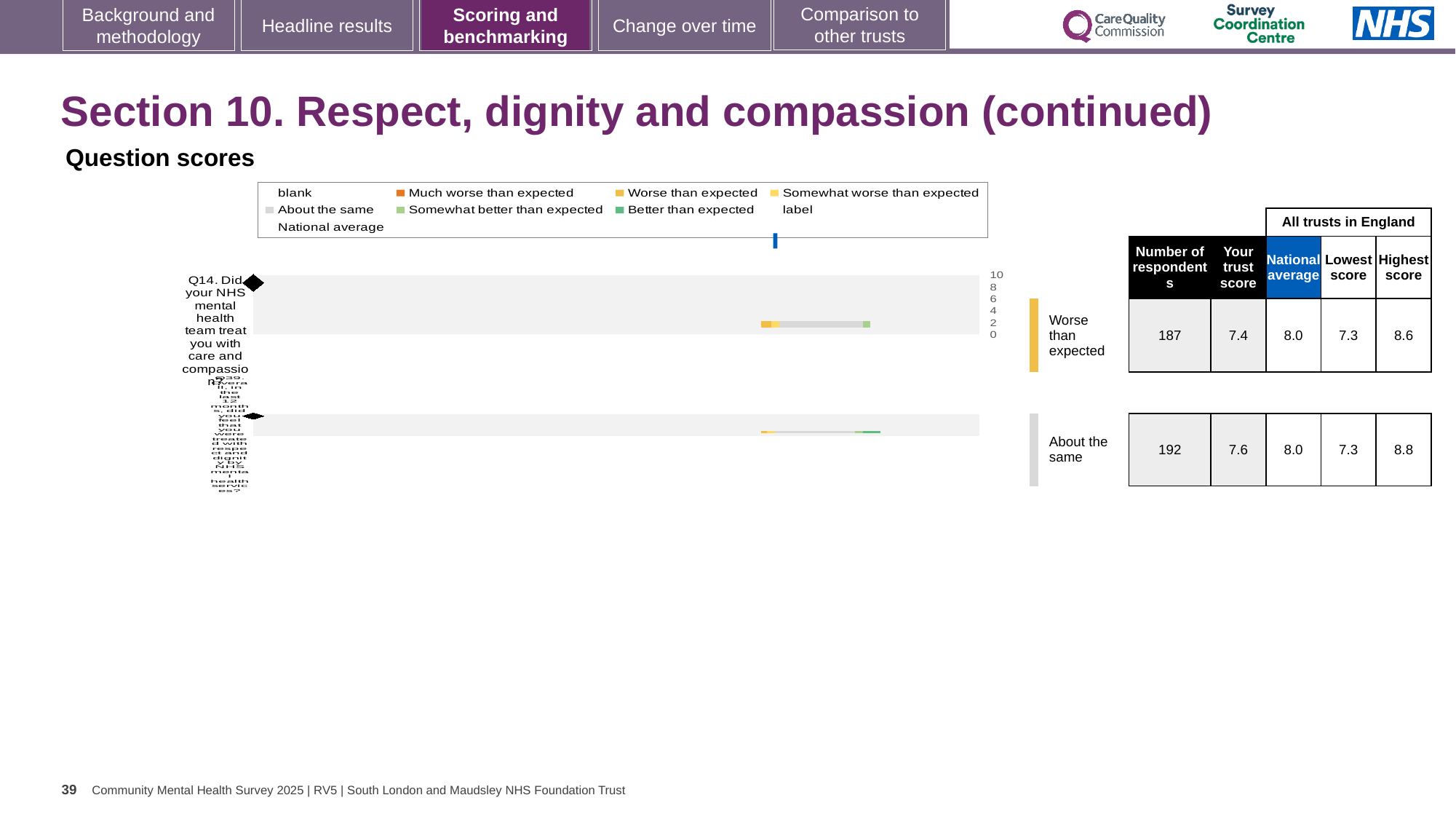
How many questions are plotted in the question scores chart? 2 What is the highest score among all trusts in England for Q39? 8.8 What is the difference between the national average (8.0) and the trust score (7.4) for Q14? 0.6 What type of chart is used to show the question scores on this slide? bar chart How many respondents answered Q14? 187 What is the national average score for Q14? 8.0 What is the difference between the highest score for Q39 (8.8) and the highest score for Q14 (8.6)? 0.2 What is the 'Your trust score' value for the second question (Q39)? 7.6 Which benchmark category is shown for Q14 in the question scores chart? Worse than expected Which question has the higher trust score, Q14 or Q39? Q39 How many respondents answered the second question (Q39)? 192 What is the 'Your trust score' value for Q14 (care and compassion)? 7.4